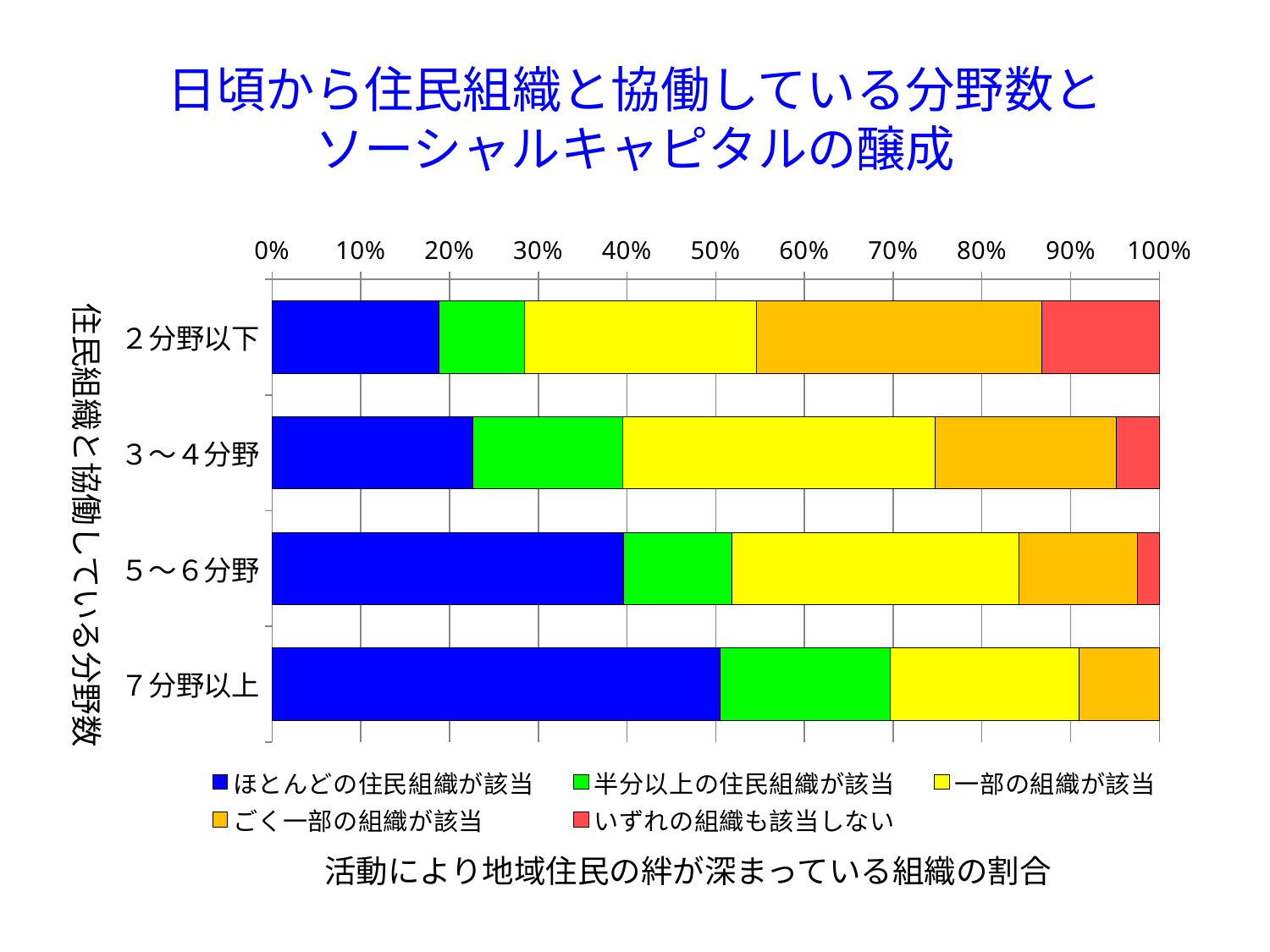
What is the label of the horizontal axis at the bottom of the chart? 活動により地域住民の絆が深まっている組織の割合 Which is larger: the share of ほとんどの住民組織が該当 for 5～6分野 or for 3～4分野? 5～6分野 Does the share of ほとんどの住民組織が該当 rise or fall as the number of fields increases from 2分野以下 to 7分野以上? rise What colour represents いずれの組織も該当しない in the legend? red What kind of chart is shown on the slide? stacked bar chart How many categories are plotted on the vertical axis? 4 Which category has the largest share for いずれの組織も該当しない? 2分野以下 Which category has the largest share for ほとんどの住民組織が該当? 7分野以上 Is the share of ほとんどの住民組織が該当 for 7分野以上 greater or less than 40%? greater Is the share of ほとんどの住民組織が該当 for 2分野以下 greater or less than 20%? less How many series does the legend list? 5 Which category has the smallest share for ほとんどの住民組織が該当? 2分野以下